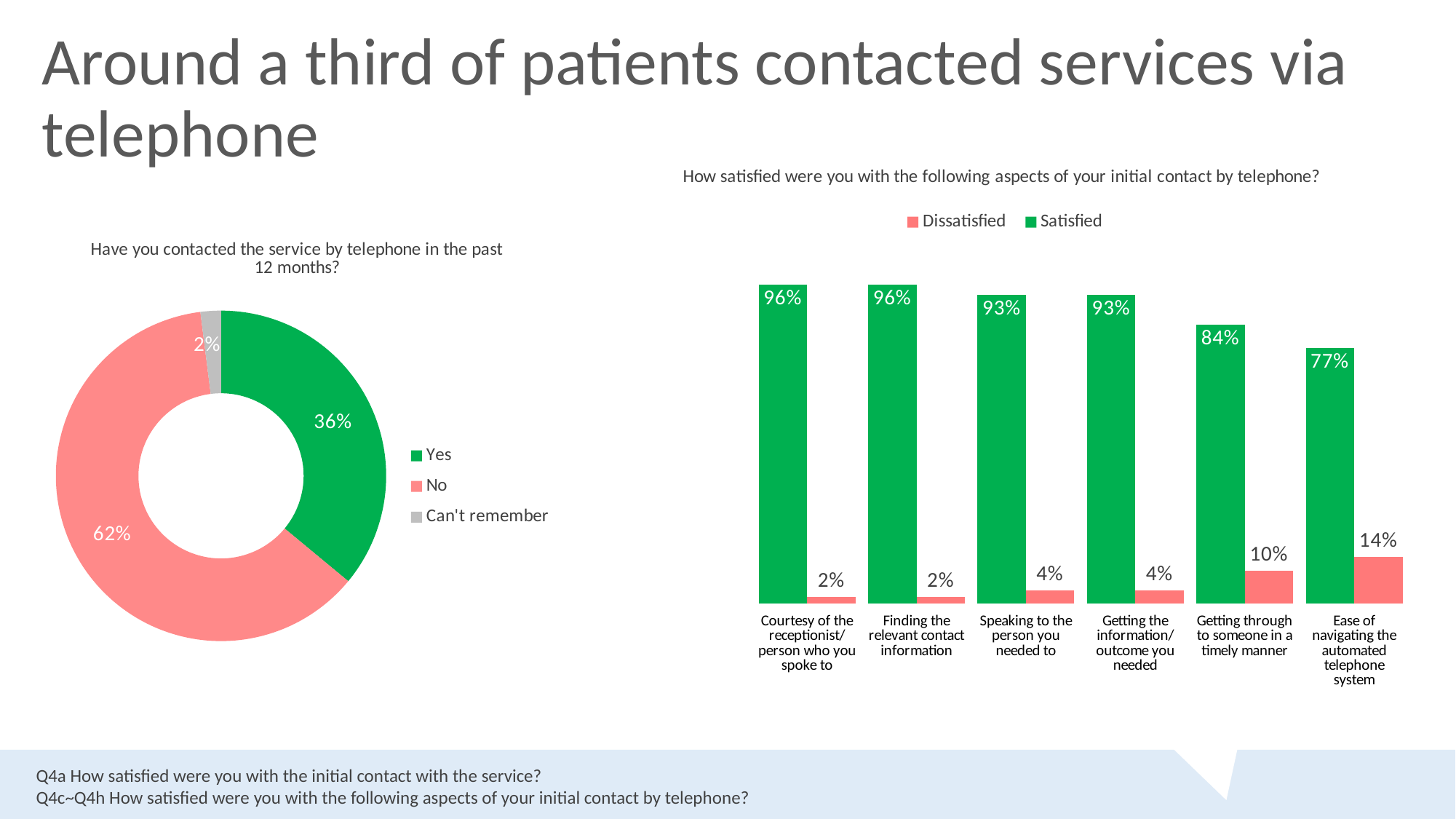
What kind of chart is 'Have you contacted the service by telephone in the past 12 months?'? Doughnut (pie) chart In the chart 'How satisfied were you with the following aspects of your initial contact by telephone?', how many aspects are shown on the x axis? 6 In the chart 'How satisfied were you with the following aspects of your initial contact by telephone?', how many series does the legend list? 2 In the chart 'How satisfied were you with the following aspects of your initial contact by telephone?', which is larger: the Dissatisfied value for 'Getting through to someone in a timely manner' or for 'Speaking to the person you needed to'? Getting through to someone in a timely manner In the chart 'Have you contacted the service by telephone in the past 12 months?', which response has the smallest share? Can't remember In the chart 'How satisfied were you with the following aspects of your initial contact by telephone?', what is the difference between the Satisfied values for 'Courtesy of the receptionist/person who you spoke to' and 'Ease of navigating the automated telephone system'? 19 percentage points In the chart 'How satisfied were you with the following aspects of your initial contact by telephone?', which aspect has the lowest Satisfied value? Ease of navigating the automated telephone system In the chart 'How satisfied were you with the following aspects of your initial contact by telephone?', what is the Dissatisfied value for 'Ease of navigating the automated telephone system'? 14% In the chart 'Have you contacted the service by telephone in the past 12 months?', how many categories does the legend list? 3 In the chart 'Have you contacted the service by telephone in the past 12 months?', what share of patients answered Yes? 36% In the chart 'Have you contacted the service by telephone in the past 12 months?', what share of patients answered No? 62% In the chart 'How satisfied were you with the following aspects of your initial contact by telephone?', what is the Satisfied value for 'Getting through to someone in a timely manner'? 84%